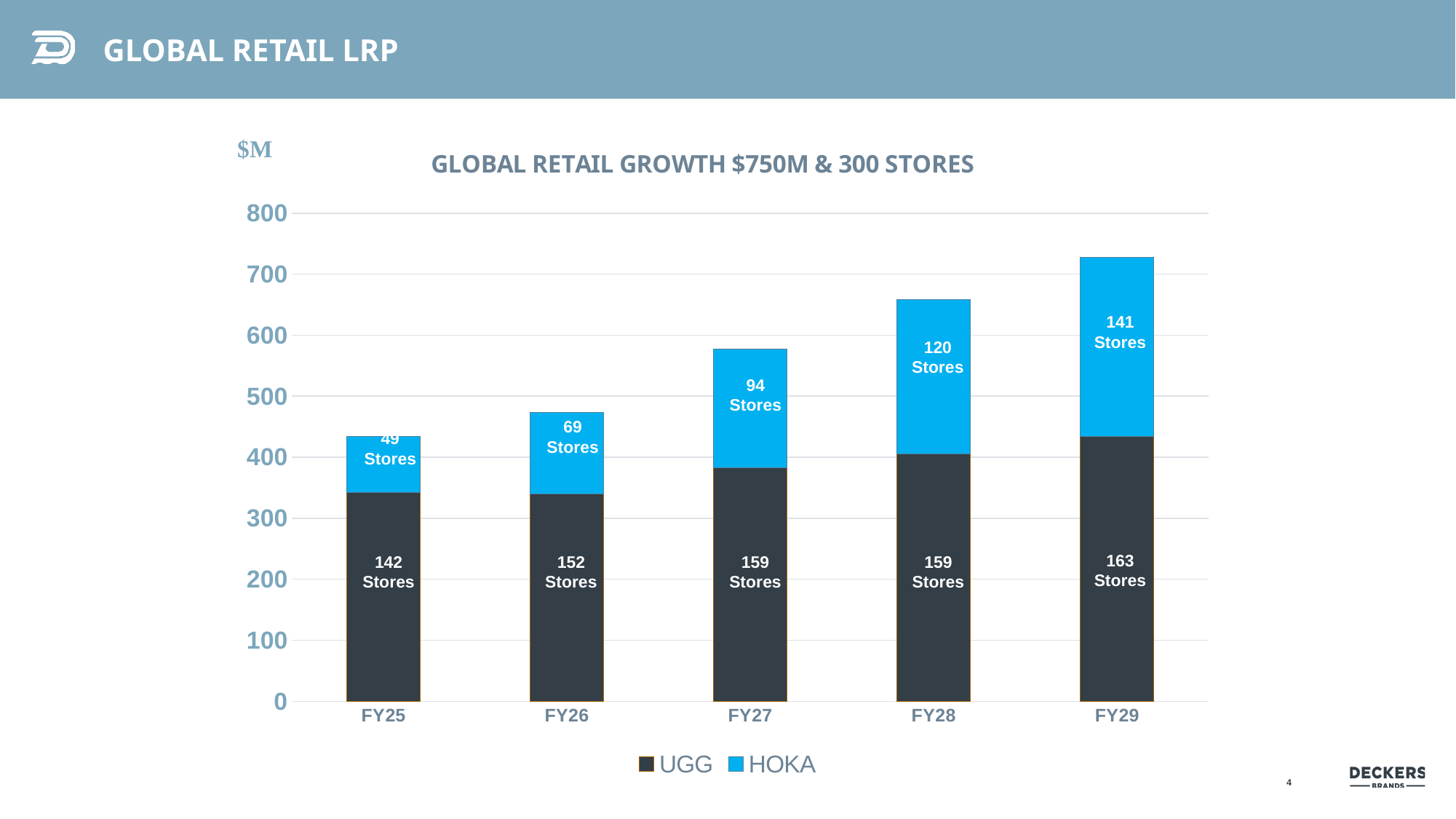
Is the total value of the FY29 bar greater or less than 700? greater In which fiscal year is the HOKA store count label the highest? FY29 Do the total bar values rise or fall from FY25 to FY29? rise How many fiscal years are shown on the x axis? 5 How many series does the legend list? 2 Is the total value of the FY27 bar greater or less than 600? less How many HOKA stores are labelled for FY27? 94 Stores What kind of chart is shown on the slide? Stacked bar chart In which fiscal year is the UGG store count label the lowest? FY25 What is the difference between the HOKA store count in FY29 and in FY25? 92 How many HOKA stores are labelled for FY25? 49 Stores How many UGG stores are labelled for FY29? 163 Stores